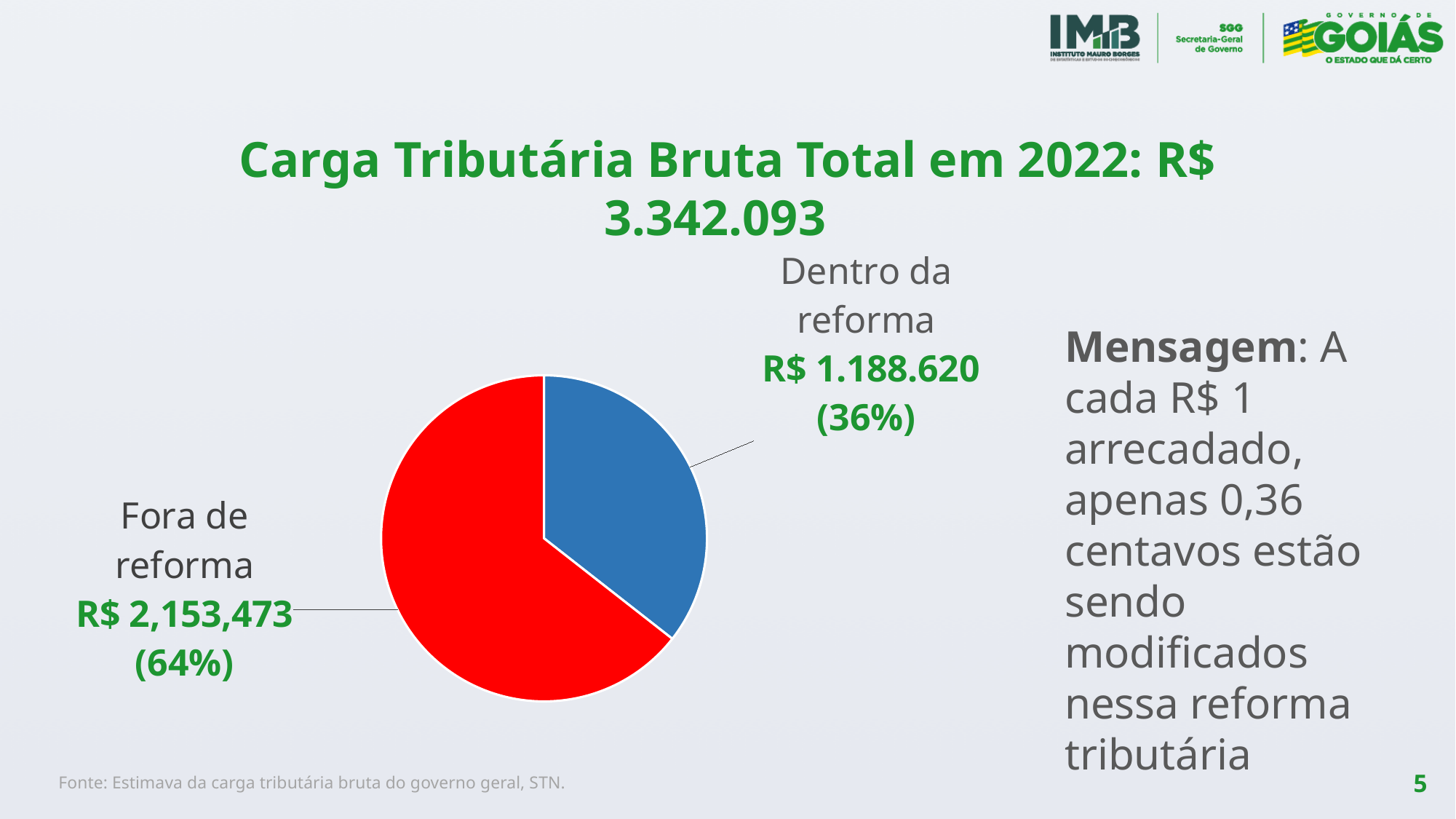
Which slice of the pie chart is the largest? Fora de reforma Which is larger, "Dentro da reforma" or "Fora de reforma"? Fora de reforma What is the value for "Fora de reforma" in the pie chart? R$ 2,153,473 Which slice of the pie chart is the smallest? Dentro da reforma What kind of chart is shown on the slide? pie chart What is the value for "Dentro da reforma" in the pie chart? R$ 1.188.620 What is the total gross tax burden for 2022 stated in the chart title? R$ 3.342.093 How many slices does the pie chart have? 2 What share of the pie does "Fora de reforma" represent? 64% What share of the pie does "Dentro da reforma" represent? 36% What colour is the "Fora de reforma" slice? red What colour is the "Dentro da reforma" slice? blue